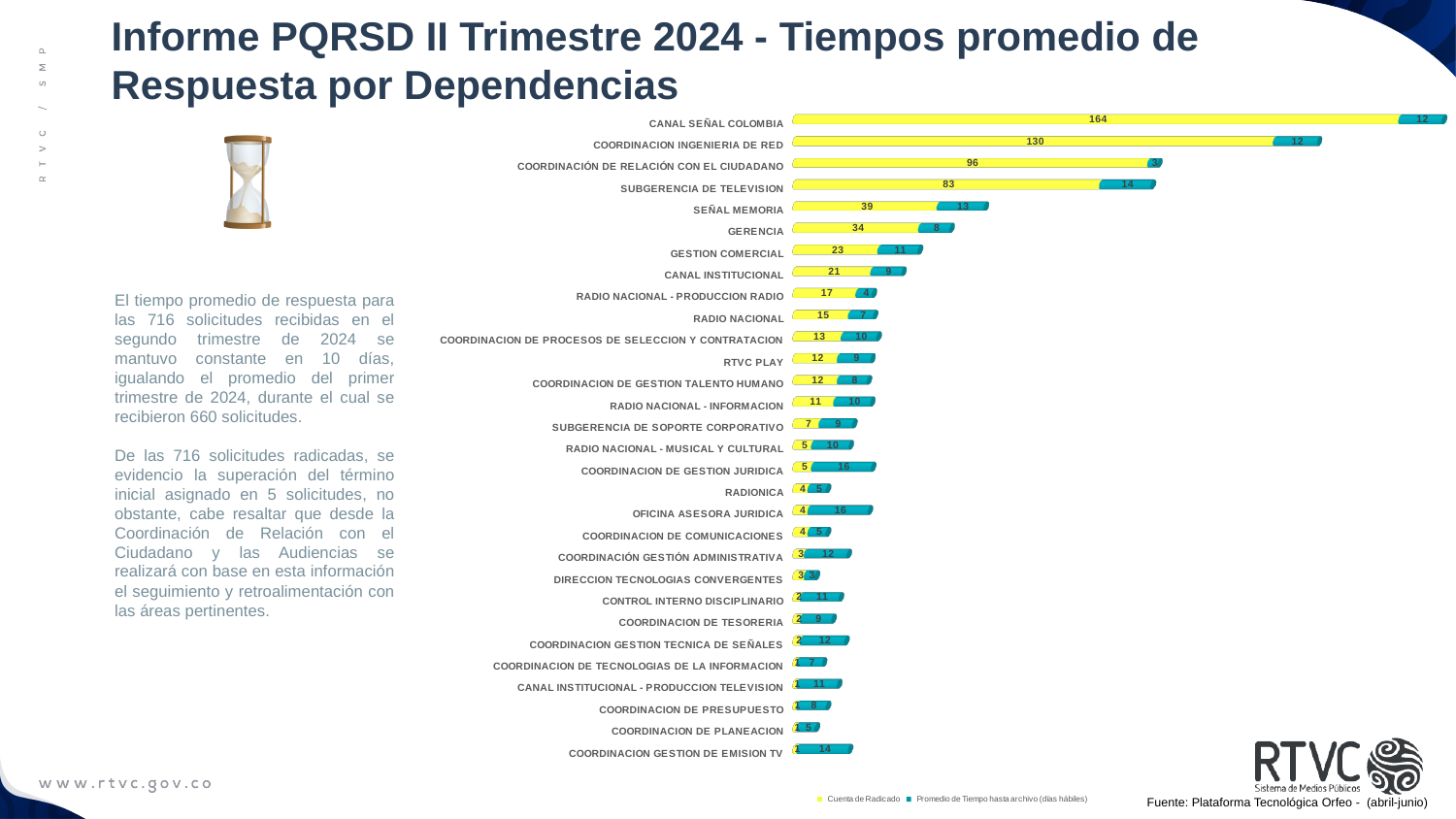
What is the difference in Cuenta de Radicado between SUBGERENCIA DE TELEVISION and SEÑAL MEMORIA? 44 How many series does the chart legend list? 2 What kind of chart is shown on the slide? Bar chart What is the Promedio de Tiempo hasta archivo (días hábiles) value for GERENCIA? 8 What is the difference in Cuenta de Radicado between CANAL SEÑAL COLOMBIA and COORDINACION INGENIERIA DE RED? 34 What is the Promedio de Tiempo hasta archivo (días hábiles) value for SUBGERENCIA DE TELEVISION? 14 Which series is shown in yellow in the chart? Cuenta de Radicado What is the Cuenta de Radicado value for COORDINACION INGENIERIA DE RED? 130 How many dependencies (categories) are shown in the chart? 30 Which dependency has the highest Cuenta de Radicado? CANAL SEÑAL COLOMBIA What is the Cuenta de Radicado value for CANAL SEÑAL COLOMBIA? 164 Which has a larger Cuenta de Radicado, SEÑAL MEMORIA or GERENCIA? SEÑAL MEMORIA